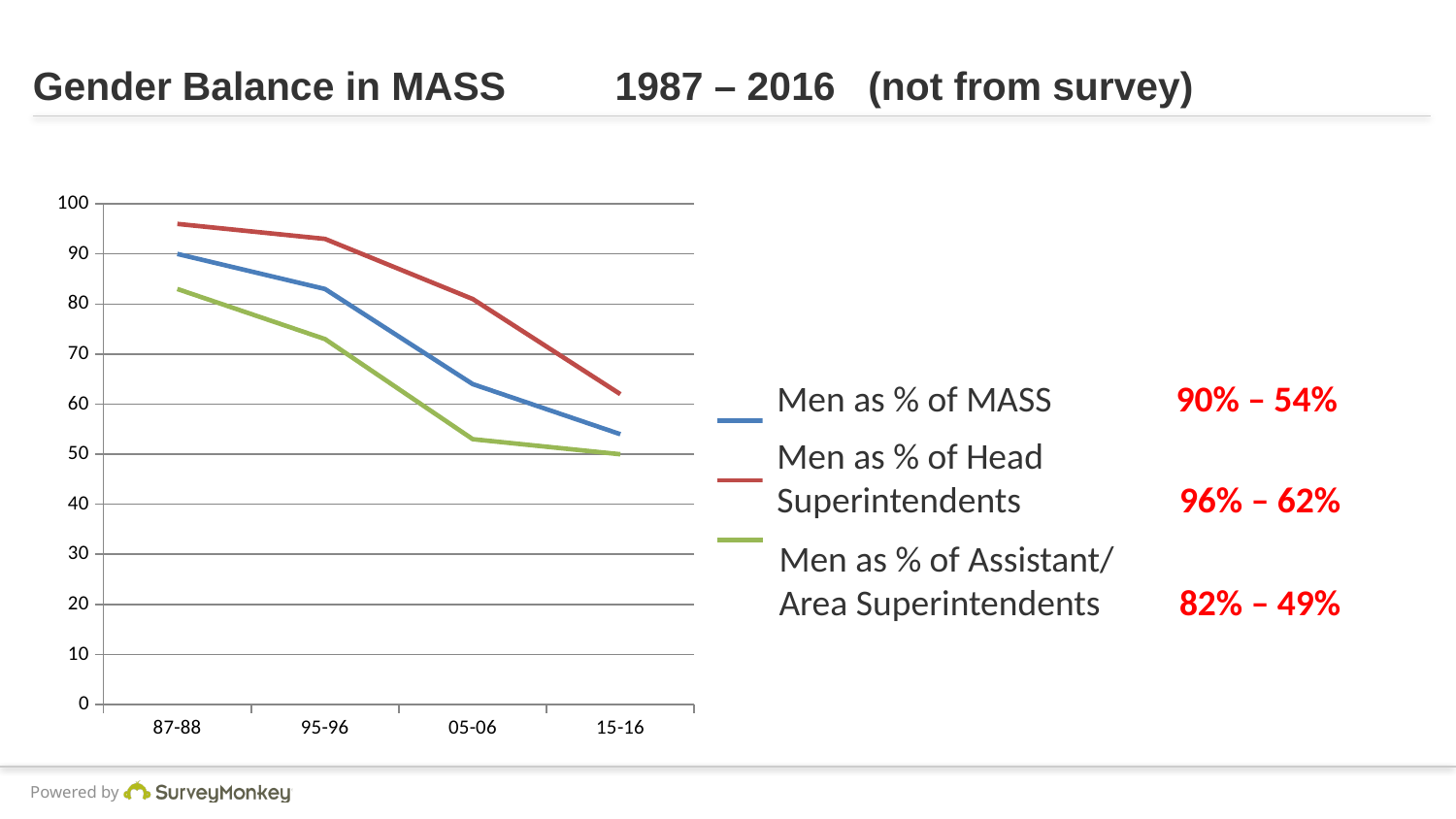
In 05-06, which is larger: Men as % of Head Superintendents or Men as % of Assistant/Area Superintendents? Men as % of Head Superintendents How many series does the legend list? 3 How many time periods are shown on the x axis? 4 What kind of chart is shown on the slide? line chart By how many percentage points did Men as % of MASS fall from 87-88 to 15-16? 36 What was Men as % of Head Superintendents in 15-16? 62% What was Men as % of MASS in 87-88? 90% Do the values for Men as % of Head Superintendents rise or fall from 87-88 to 15-16? fall What was Men as % of Assistant/Area Superintendents in 87-88? 82% Which series has the highest value in 87-88? Men as % of Head Superintendents Is the value for Men as % of MASS in 05-06 greater or less than 70? less Which series has the lowest value in 15-16? Men as % of Assistant/Area Superintendents